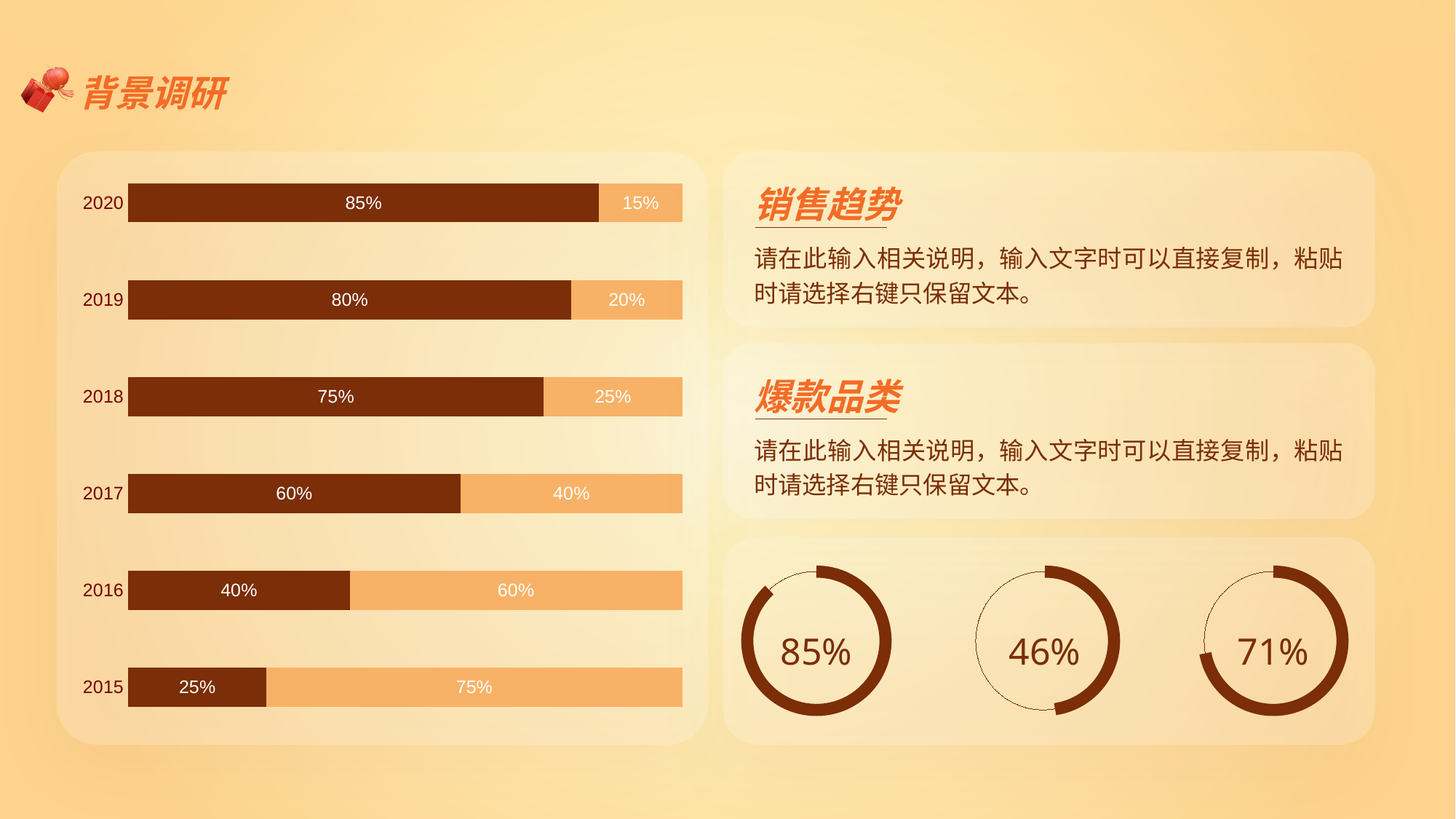
In the bar chart on the left, what is the difference between the dark brown segment for 2020 and the dark brown segment for 2015? 60% In the bar chart on the left, which year has the smallest dark brown segment? 2015 In the bar chart on the left, what is the value of the dark brown segment for 2016? 40% In the bar chart on the left, which is larger for 2018: the dark brown segment or the light orange segment? the dark brown segment In the bar chart on the left, what is the value of the light orange segment for 2017? 40% How many years are shown in the bar chart on the left? 6 What value is shown in the middle ring gauge at the bottom right of the slide? 46% In the bar chart on the left, what is the value of the dark brown segment for 2020? 85% In the bar chart on the left, does the dark brown segment rise or fall from 2015 to 2020? rise In the bar chart on the left, what is the total of the two segments for 2019? 100% What kind of chart is shown on the left of the slide? stacked bar chart In the bar chart on the left, which year has the largest dark brown segment? 2020